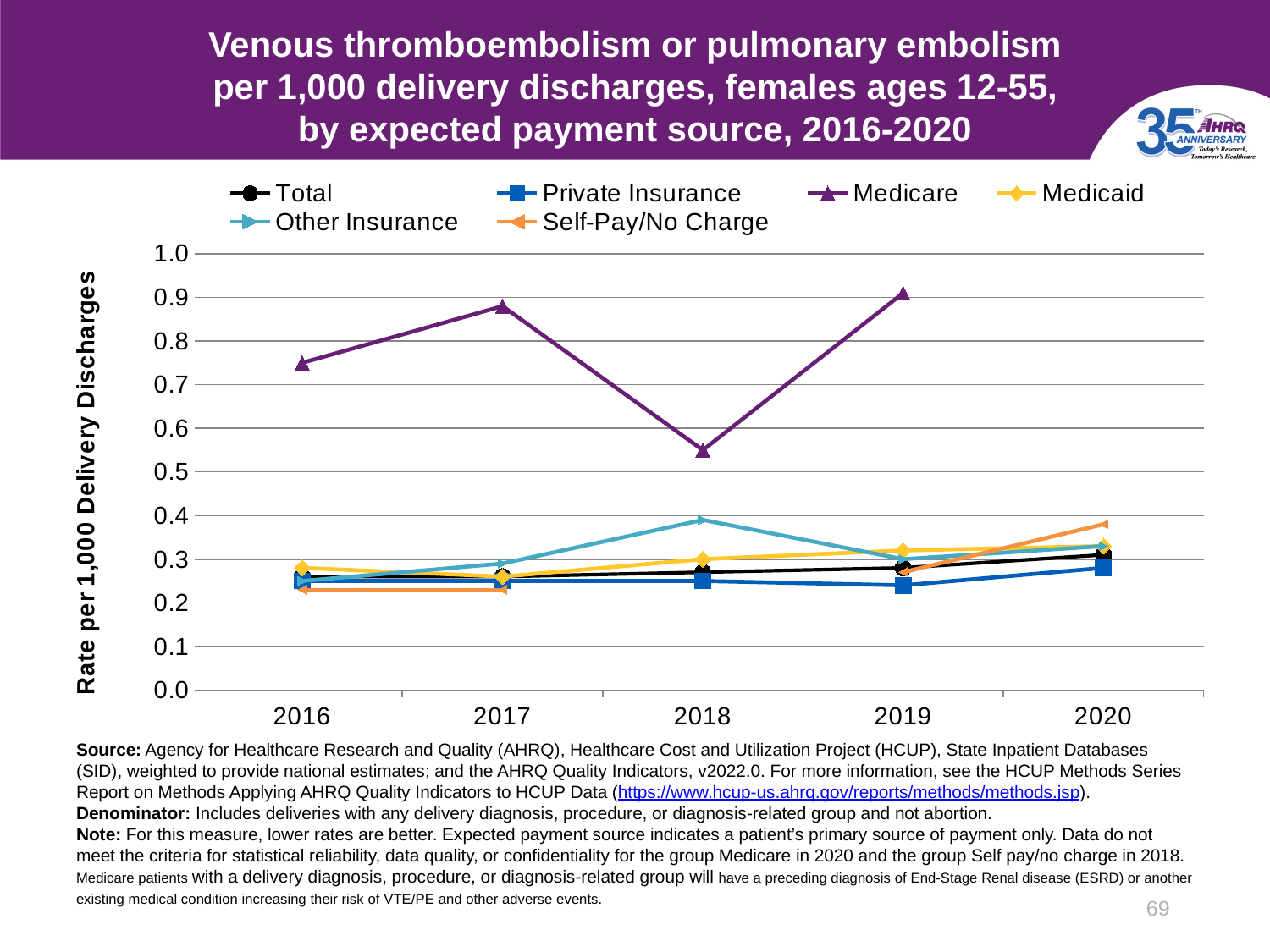
Which payment source has the highest rate in 2018? Medicare Is the Self-Pay/No Charge value for 2020 greater or less than 0.3? greater Is the Private Insurance value for 2019 greater or less than 0.3? less What kind of chart is shown on the slide? Line chart Which payment source has the lowest rate in 2019? Private Insurance How many years are shown on the x axis? 5 Does the Medicare rate rise or fall from 2017 to 2018? Fall In which year is the Medicare rate lowest? 2018 Which is larger, the Medicare value for 2017 or for 2018? 2017 How many series does the legend list? 6 Is the Medicare value for 2016 greater or less than 0.7? greater